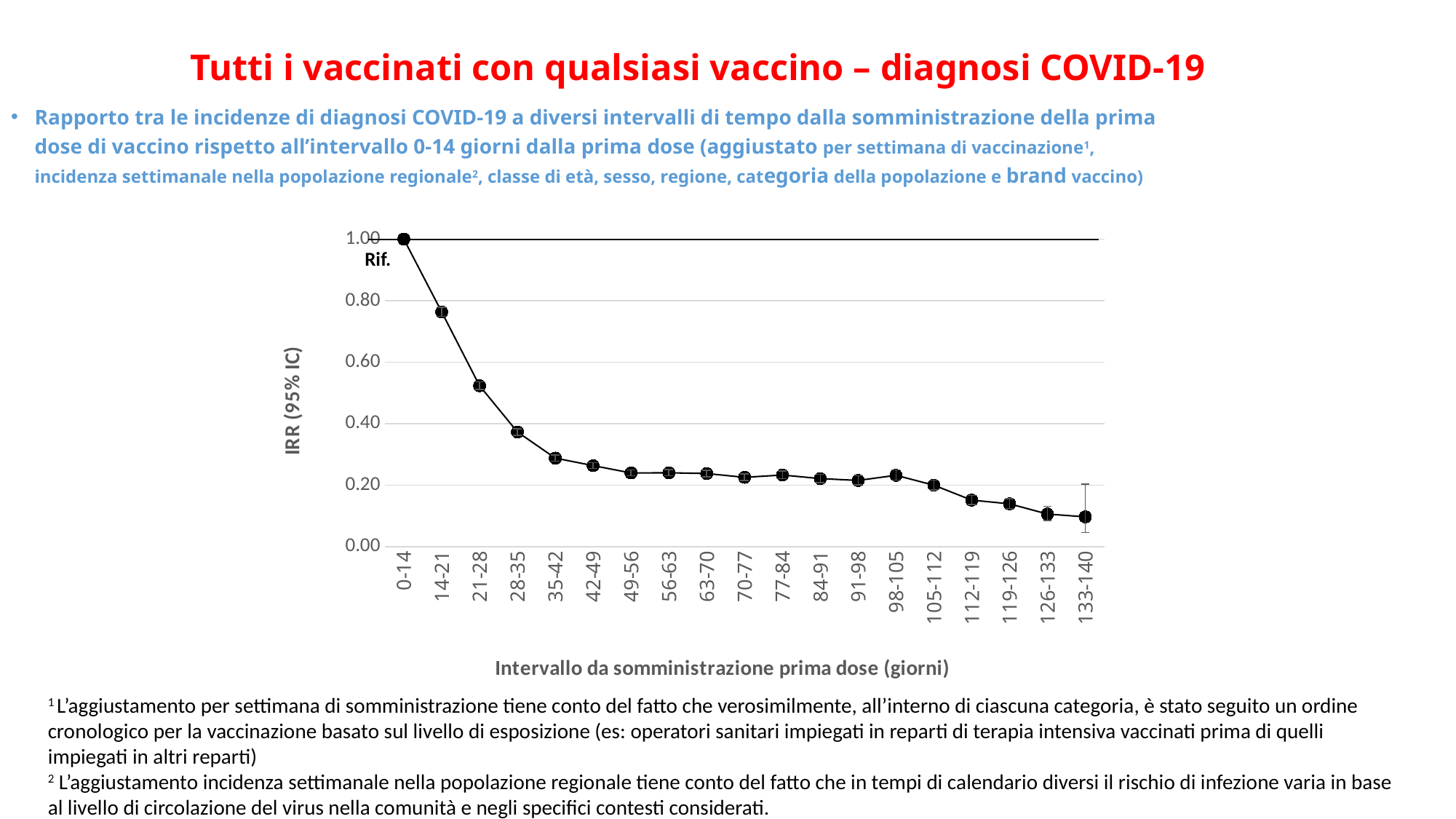
What is the label of the y axis? IRR (95% IC) Which has a larger IRR value, the 14-21 interval or the 21-28 interval? 14-21 Is the IRR value for the 112-119 interval greater or less than 0.20? less What label is printed next to the first data point at 0-14? Rif. What is the IRR value for the 0-14 day interval (the reference point)? 1.00 Is the IRR value for the 14-21 interval greater or less than 0.60? greater Which interval has the highest IRR value? 0-14 How many time intervals are plotted along the x axis? 19 Is the IRR value for the 21-28 interval greater or less than 0.40? greater Do the IRR values generally rise or fall as the interval from the first dose increases? fall What kind of chart is shown on the slide? line chart